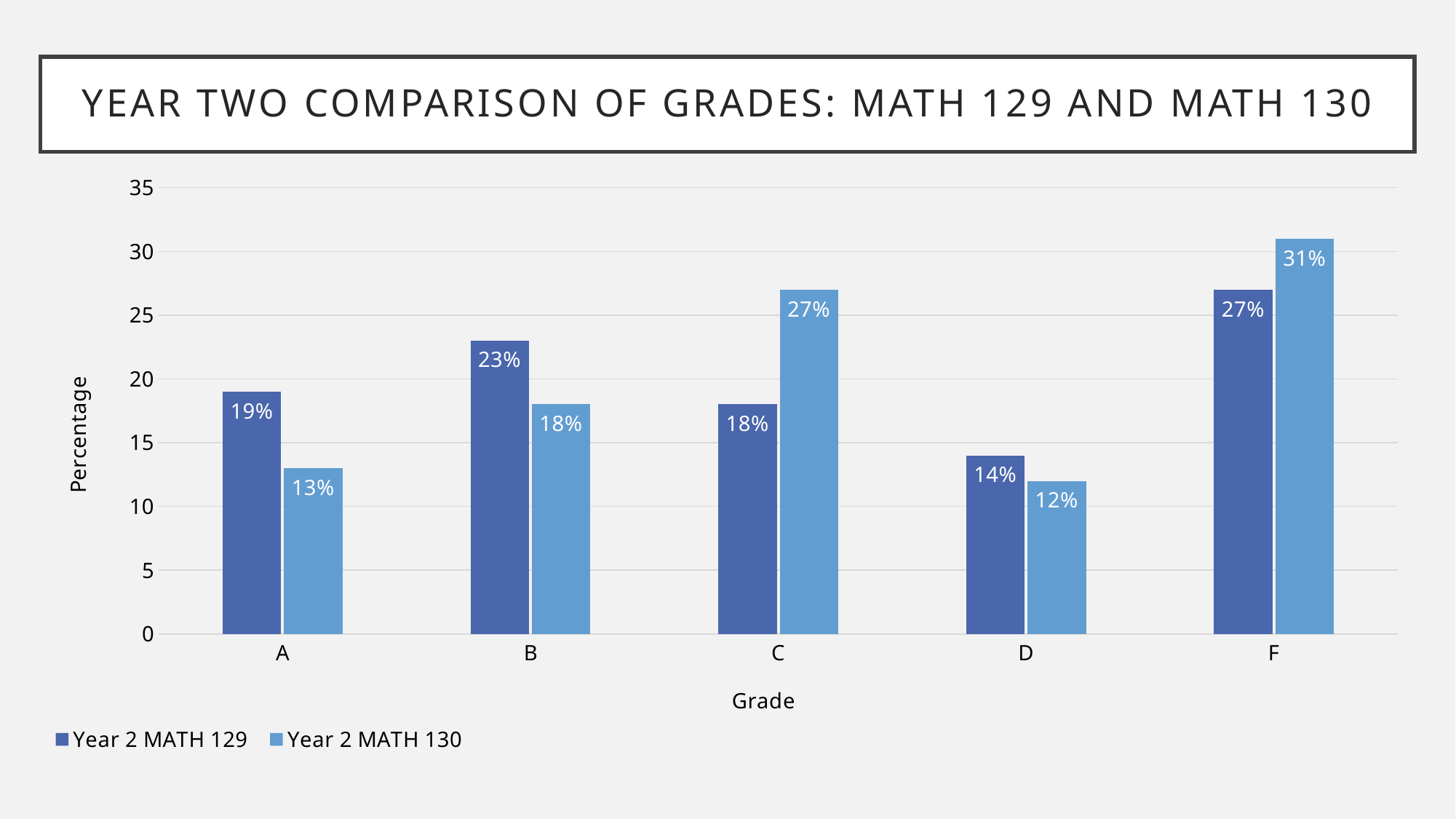
What is the value for grade D in the Year 2 MATH 130 series? 12% What percentage of Year 2 MATH 130 students received a grade of F? 31% How many grade categories are shown on the x axis? 5 What percentage of Year 2 MATH 129 students received a grade of B? 23% Is the Year 2 MATH 129 value for grade F greater or less than 25? greater What kind of chart is shown on the slide? Bar chart What is the difference between the Year 2 MATH 130 and Year 2 MATH 129 percentages for grade C? 9% Which grade has the lowest percentage for Year 2 MATH 129? D What is the label of the vertical axis? Percentage Which grade has the highest percentage for Year 2 MATH 130? F How many series does the legend list? 2 For grade A, which series has the larger percentage, Year 2 MATH 129 or Year 2 MATH 130? Year 2 MATH 129